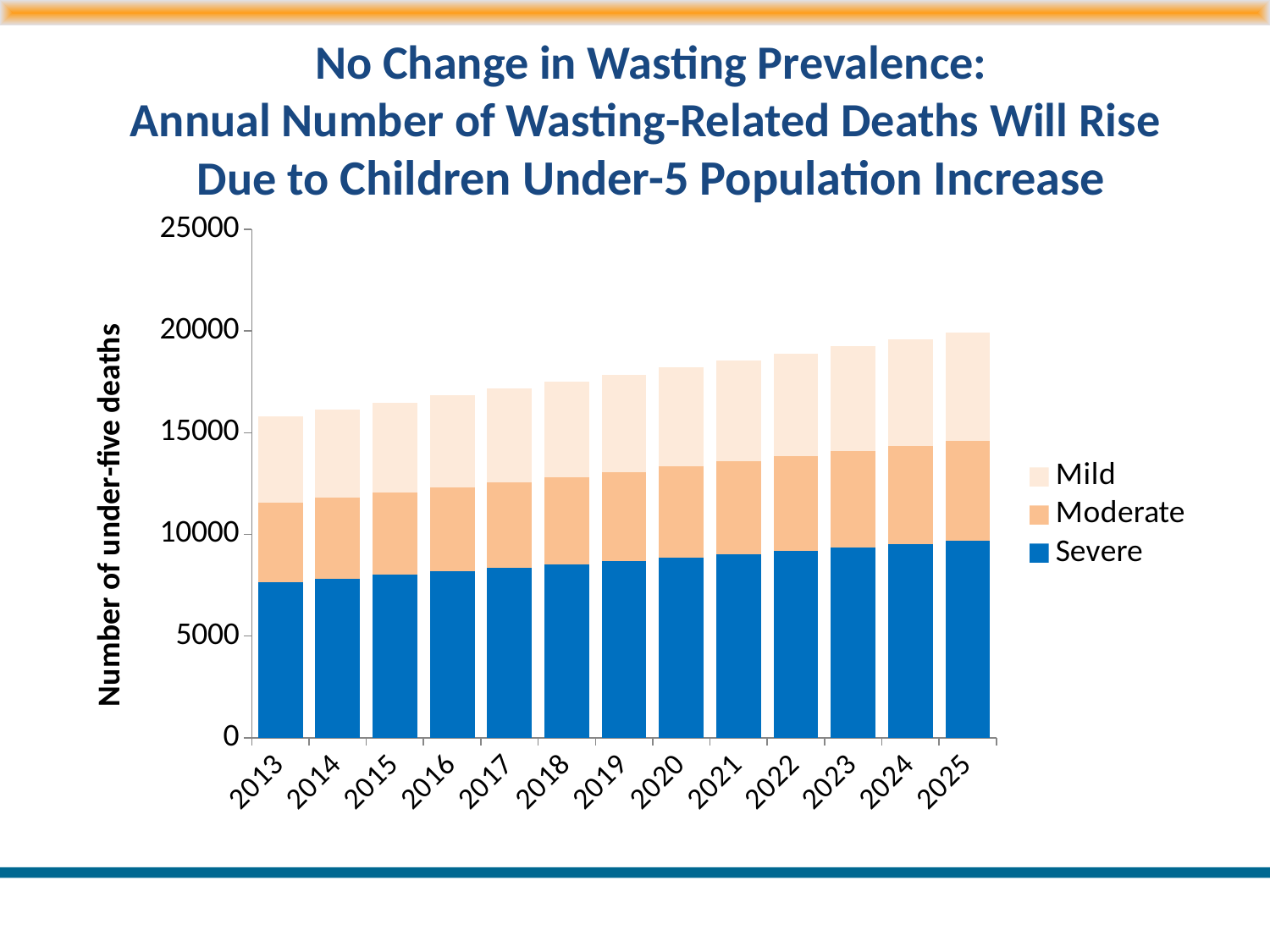
Which is larger, the total under-five deaths in 2025 or in 2013? 2025 How many years are shown along the x axis of the chart? 13 Which year has the highest total number of under-five deaths? 2025 Is the value for Severe in 2020 greater or less than 10000? less What kind of chart is shown on the slide? Stacked bar chart Do the total under-five deaths rise or fall from 2013 to 2025? Rise Is the value for Severe in 2013 greater or less than 5000? greater What is the label on the y axis of the chart? Number of under-five deaths How many series does the chart's legend list? 3 Is the total number of under-five deaths in 2019 greater or less than 15000? greater Which series is shown at the bottom of each stacked bar? Severe Which year has the lowest total number of under-five deaths? 2013